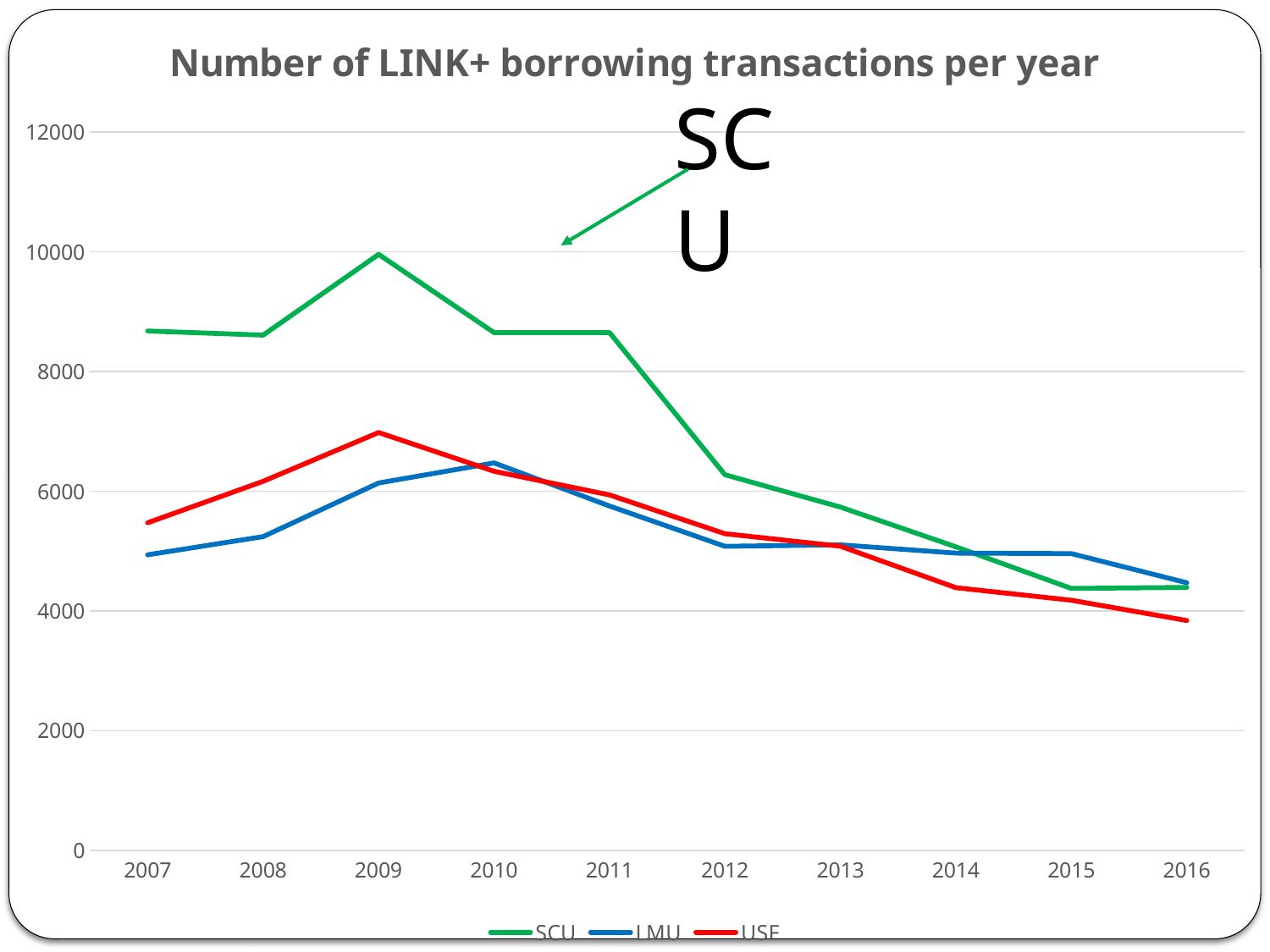
What kind of chart is shown on the slide? line chart Which series has the larger value in 2016, LMU or USF? LMU In which year does the USF series reach its lowest value? 2016 How many years are shown on the x axis? 10 In which year does the USF series reach its highest value? 2009 Is the value for SCU in 2009 greater or less than 8000? greater Is the value for USF in 2014 greater or less than 5000? less In which year does the SCU series reach its highest value? 2009 Is the value for USF in 2009 greater or less than 6000? greater Does the SCU series rise or fall from 2011 to 2016? fall How many series does the legend list? 3 Which series has the larger value in 2007, LMU or USF? USF